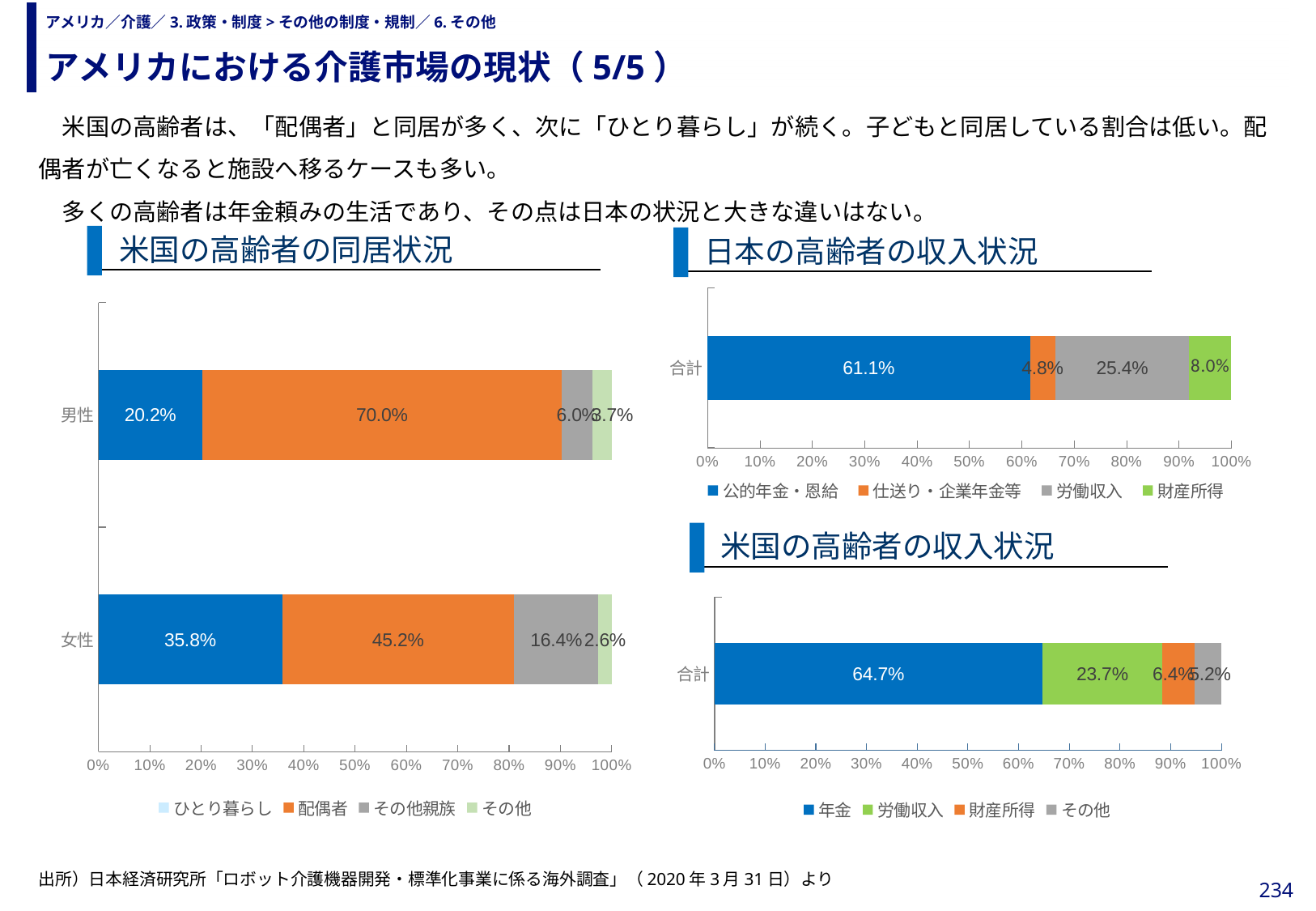
In the chart titled 日本の高齢者の収入状況, which series has the lowest value? 仕送り・企業年金等 In the chart titled 米国の高齢者の同居状況, what is the difference between the 配偶者 values for 男性 and 女性? 24.8% In the chart titled 米国の高齢者の同居状況, how many series does the legend list? 4 What kind of chart is the chart titled 米国の高齢者の収入状況? Stacked bar chart In the chart titled 日本の高齢者の収入状況, what is the value of 公的年金・恩給? 61.1% In the chart titled 日本の高齢者の収入状況, what is the difference between 労働収入 and 財産所得? 17.4% In the chart titled 米国の高齢者の収入状況, which series has the highest value? 年金 In the chart titled 米国の高齢者の収入状況, what is the value of 労働収入? 23.7% In the chart titled 米国の高齢者の同居状況, what is the value of ひとり暮らし for 女性? 35.8% In the chart titled 米国の高齢者の同居状況, which is larger, the ひとり暮らし value for 男性 or for 女性? 女性 In the chart titled 米国の高齢者の同居状況, what is the value of 配偶者 for 男性? 70.0% In the chart titled 米国の高齢者の同居状況, what is the value of その他親族 for 女性? 16.4%